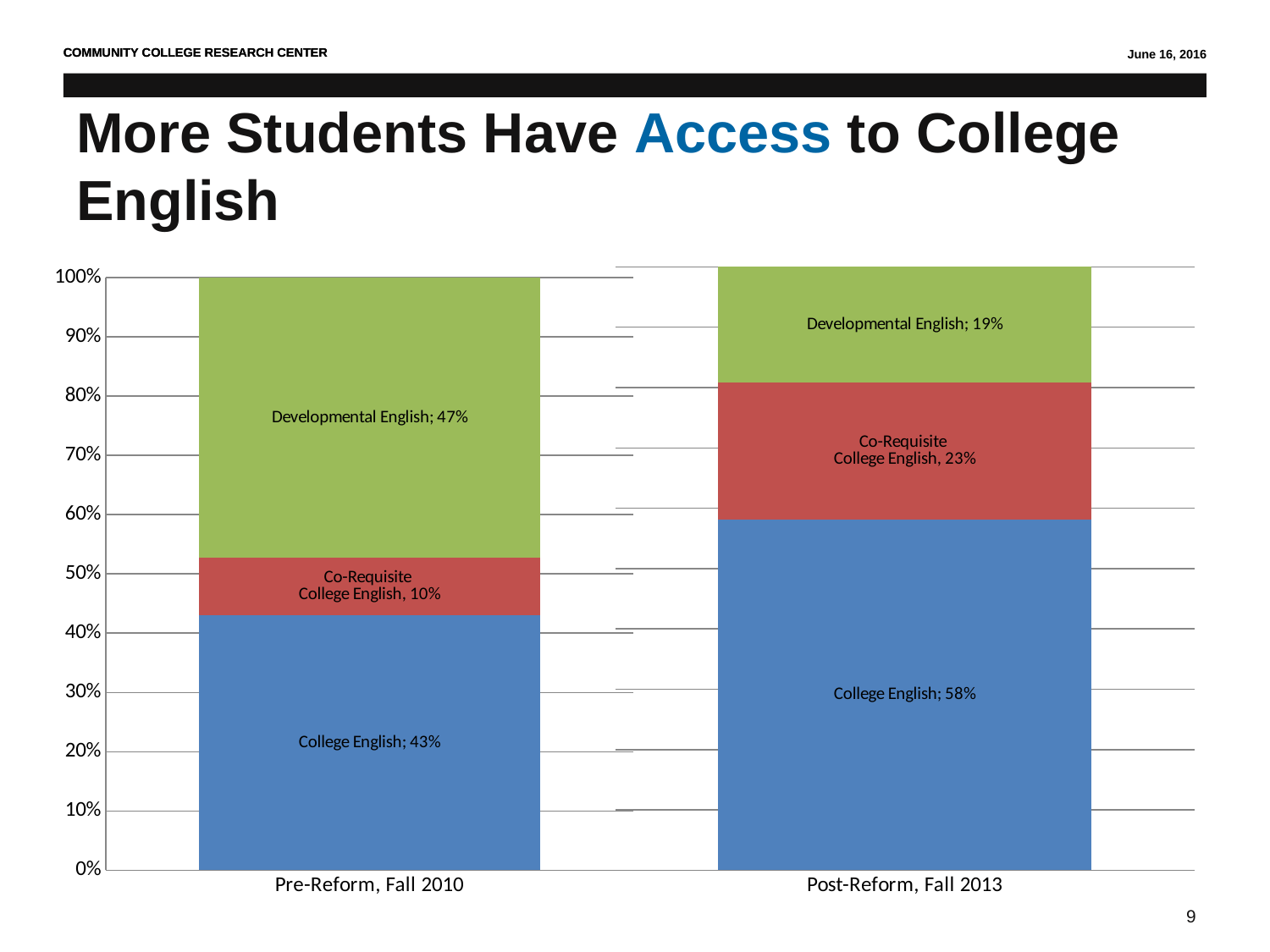
By how many percentage points did the Developmental English share fall from Pre-Reform, Fall 2010 to Post-Reform, Fall 2013? 28 What is the Co-Requisite College English share for Post-Reform, Fall 2013? 23% What percentage of students were in College English in Pre-Reform, Fall 2010? 43% What is the total of the three segments in the Pre-Reform, Fall 2010 bar? 100% What is the Developmental English share for Pre-Reform, Fall 2010? 47% How many categories are shown on the x axis? 2 Which period has the higher College English share, Pre-Reform, Fall 2010 or Post-Reform, Fall 2013? Post-Reform, Fall 2013 What is the difference in Co-Requisite College English share between Post-Reform, Fall 2013 and Pre-Reform, Fall 2010? 13 percentage points Which segment is the largest in the Pre-Reform, Fall 2010 bar? Developmental English What kind of chart is shown on the slide? Stacked bar chart What percentage of students were in Developmental English in Post-Reform, Fall 2013? 19% Which segment is the smallest in the Post-Reform, Fall 2013 bar? Developmental English